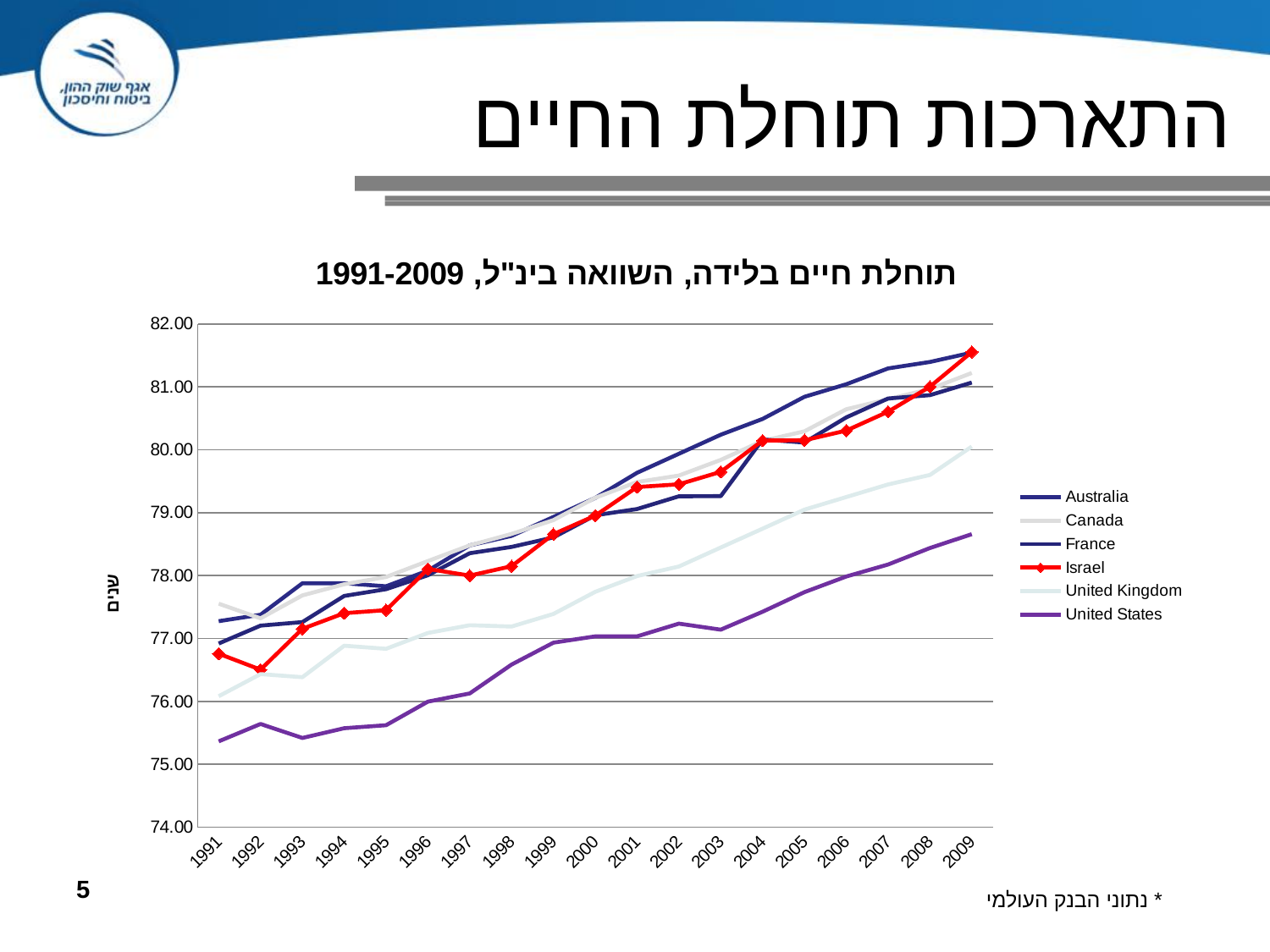
In 2000, which is larger: the value for United Kingdom or the value for United States? United Kingdom Is the value for United States in 2009 greater or less than 78.00? greater Which country has the lowest value in 1991? United States Which series is drawn in red with diamond markers? Israel How many series does the legend list? 6 Is the value for Israel in 2009 greater or less than 81.00? greater How many years are shown along the x axis? 19 Which country has the lowest value in 2009? United States What kind of chart is shown on the slide? line chart Is the value for Israel in 2003 greater or less than 79.00? greater Does the Israel line rise or fall from 1991 to 2009? rise